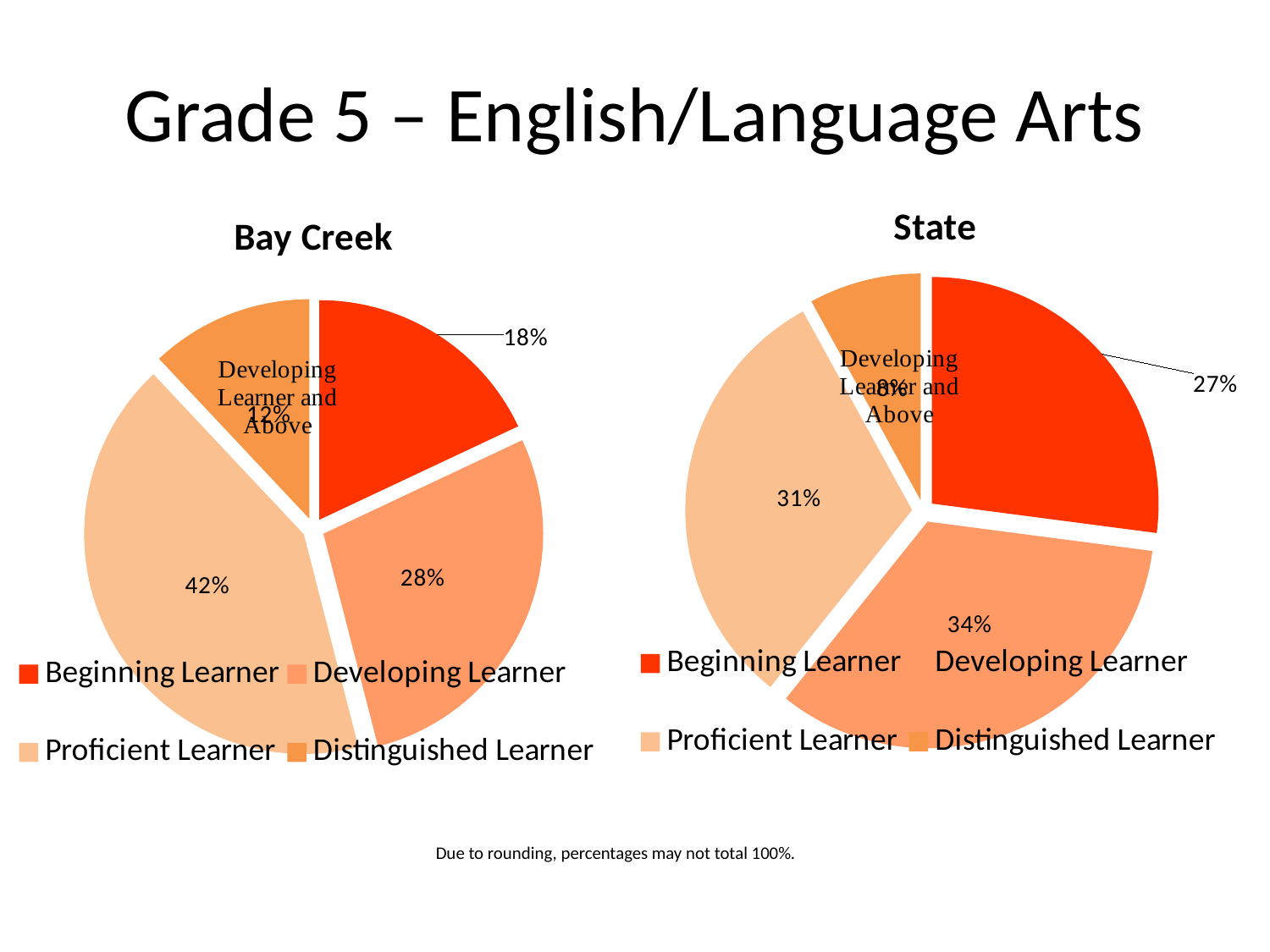
In the State chart, which category has the smallest share? Distinguished Learner In the State chart, which category has the largest share? Developing Learner What is the title of the chart on the left of the slide? Bay Creek In the State chart, what percentage is shown for Beginning Learner? 27% In the Bay Creek chart, which category has the largest share? Proficient Learner Which is larger: the Beginning Learner share for Bay Creek or for State? State In the Bay Creek chart, what percentage is shown for Proficient Learner? 42% What kind of chart is the State chart? Pie chart In the State chart, what percentage is shown for Developing Learner? 34% In the Bay Creek chart, what is the difference between the Proficient Learner and Developing Learner percentages? 14% In the Bay Creek chart, what percentage is shown for Beginning Learner? 18% How many categories does the legend of the Bay Creek chart list? 4